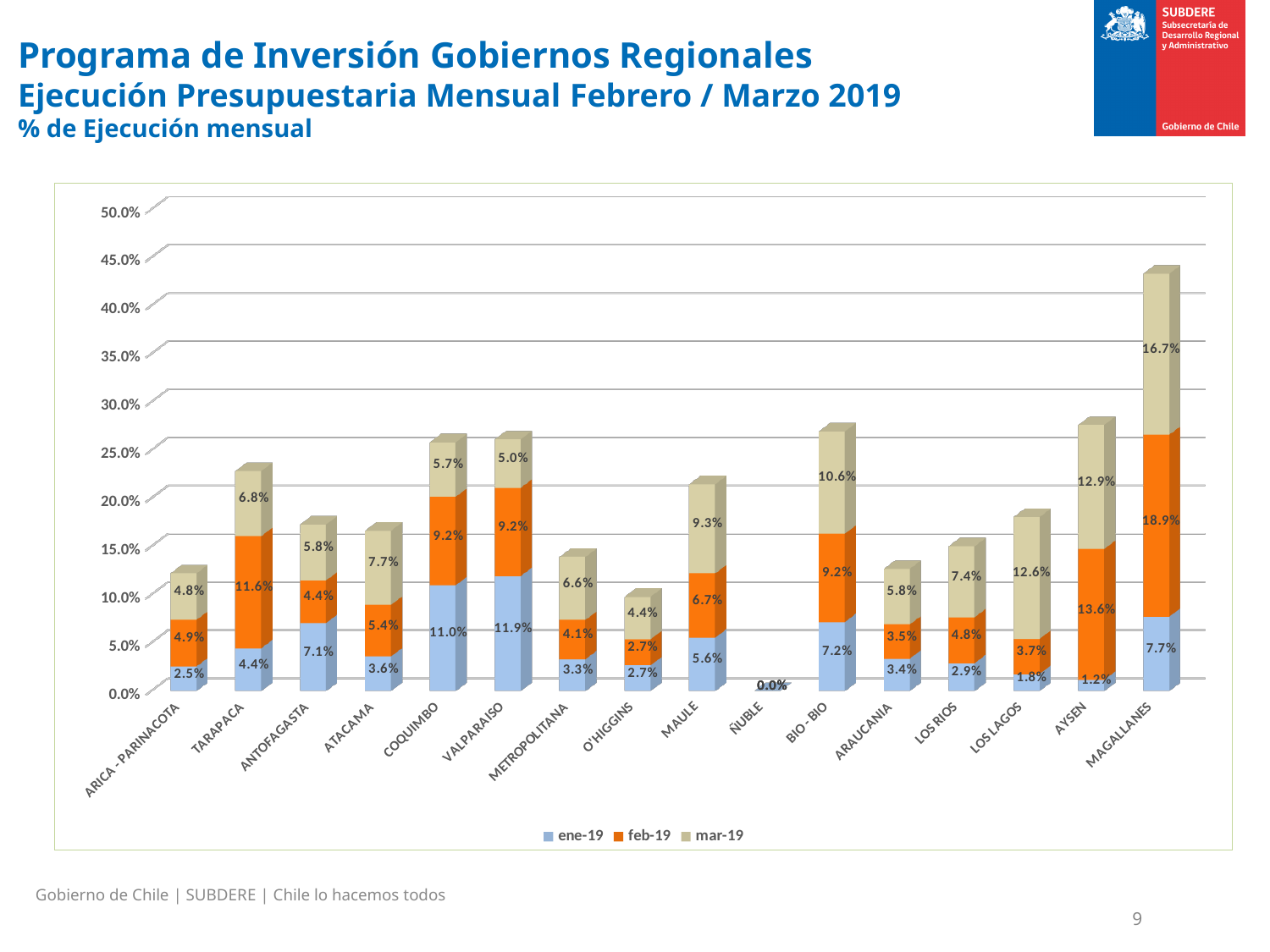
What is the feb-19 value for TARAPACA? 11.6% Which region has the lowest ene-19 value among those with a labeled ene-19 segment? AYSEN How many series does the legend list? 3 Is the total stacked value for MAGALLANES greater or less than 40.0%? greater What is the mar-19 value for LOS LAGOS? 12.6% How many regions are shown on the x axis? 16 What is the ene-19 value for COQUIMBO? 11.0% What is the difference between the feb-19 values for MAGALLANES and AYSEN? 5.3 percentage points Which is larger, the ene-19 value for VALPARAISO or for COQUIMBO? VALPARAISO Which region has the highest mar-19 value? MAGALLANES What is the total of the stacked bar for COQUIMBO? 25.9% Which region has the highest feb-19 value? MAGALLANES